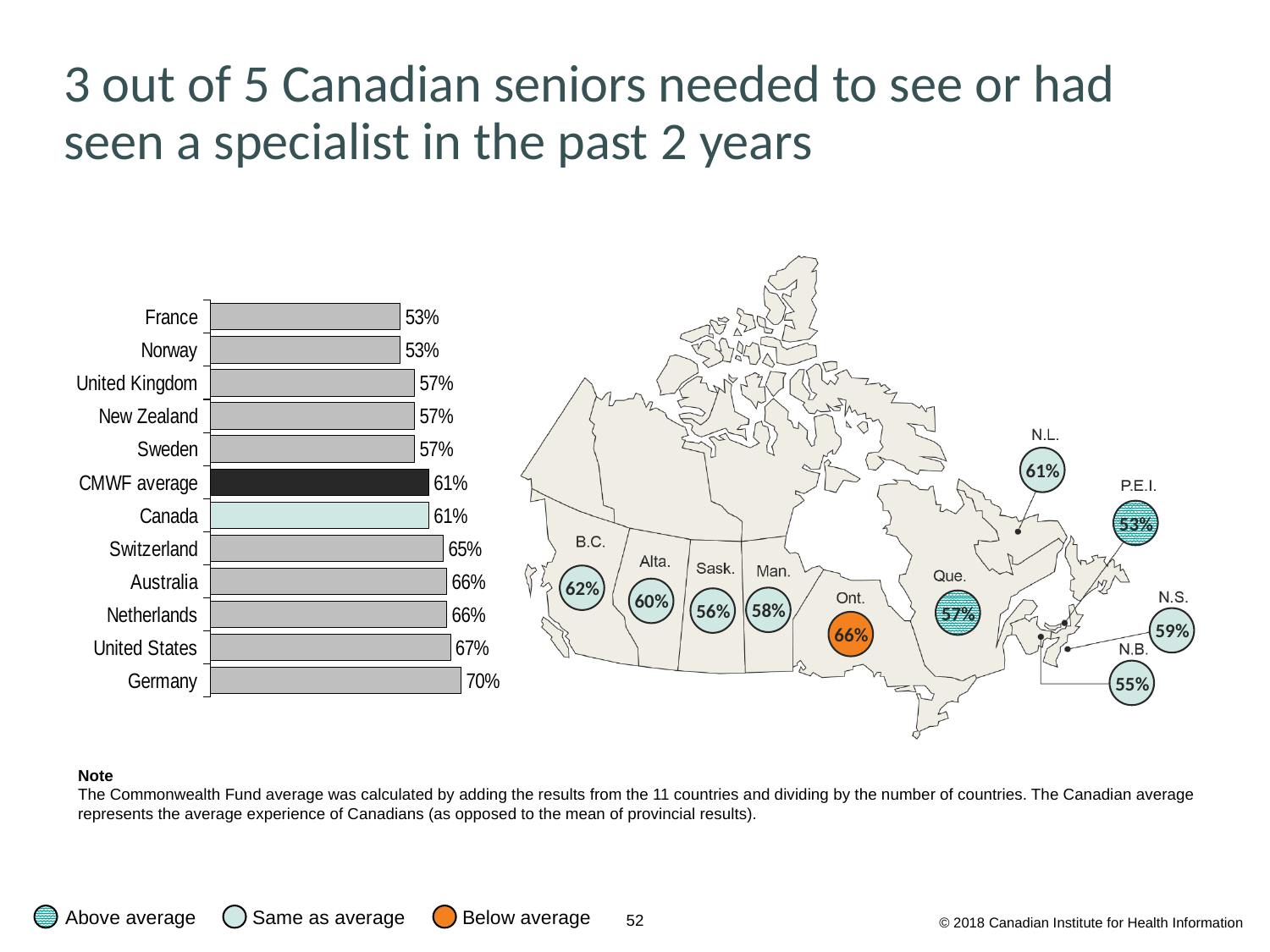
On the map, which province is marked as below average? Ont. In the bar chart, which is larger, the value for Switzerland or the value for Sweden? Switzerland On the map, which province has the lowest value? P.E.I. In the bar chart, which country has the highest value? Germany On the map, what is the difference between the values for B.C. and Sask.? 6% In the bar chart, what is the value for Germany? 70% On the map, what is the value shown for Ontario (Ont.)? 66% How many countries or averages are listed in the bar chart? 12 In the bar chart, what is the difference between Germany and France? 17% In the bar chart, what is the value for Canada? 61% What kind of chart is shown on the left of the slide? Bar chart In the bar chart, what is the value for the CMWF average? 61%